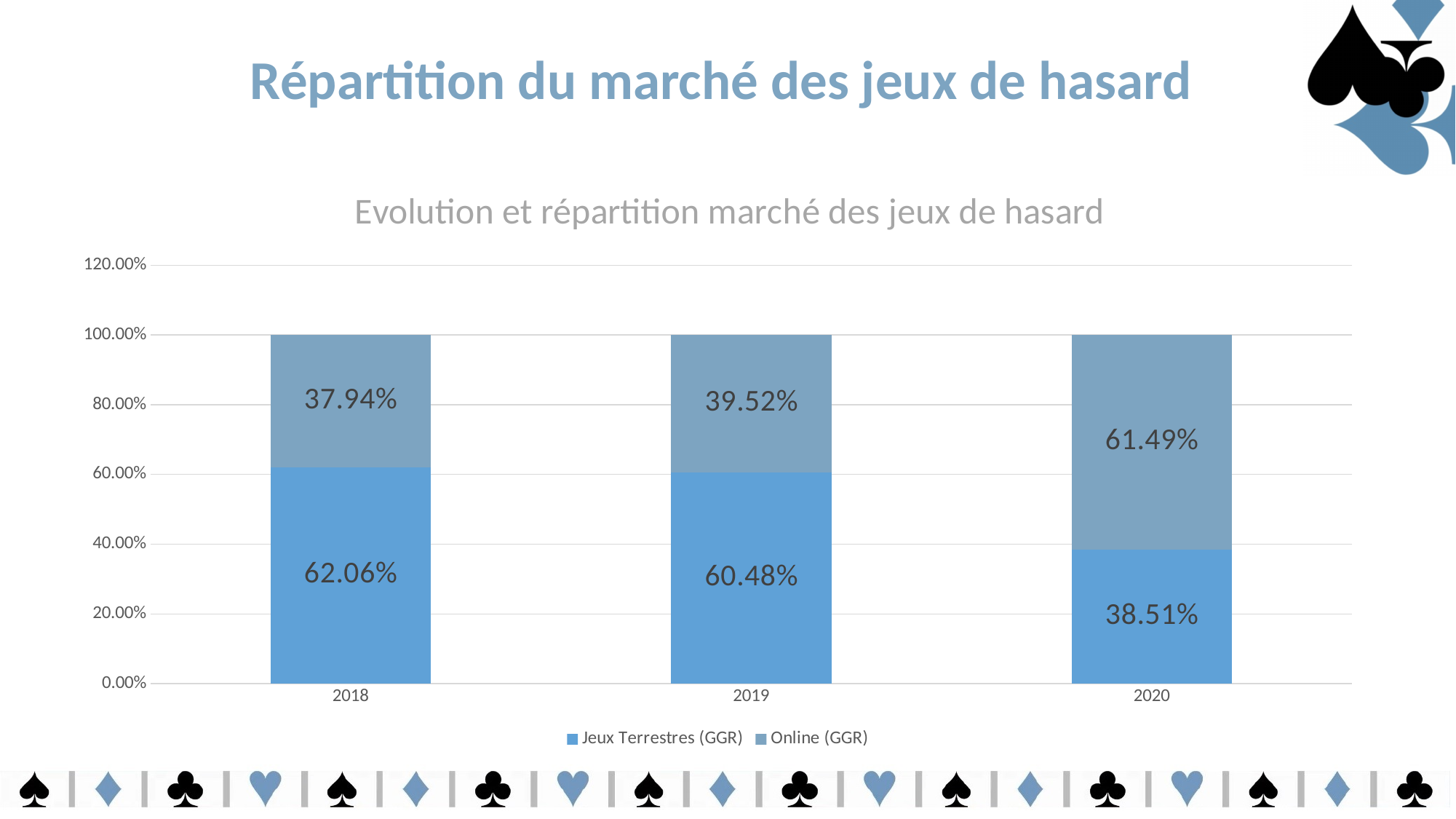
How many series does the legend list? 2 What is the value for Online (GGR) in 2019? 39.52% What is the value for Online (GGR) in 2020? 61.49% Which year has the lowest value for Online (GGR)? 2018 Which year has the highest value for Jeux Terrestres (GGR)? 2018 How many years are shown on the x axis? 3 Does the Jeux Terrestres (GGR) value rise or fall from 2018 to 2020? Fall In 2020, which is larger: Jeux Terrestres (GGR) or Online (GGR)? Online (GGR) What is the chart's title? Evolution et répartition marché des jeux de hasard What is the difference between the Online (GGR) value in 2020 and in 2019? 21.97% What is the value for Jeux Terrestres (GGR) in 2018? 62.06% What kind of chart is shown? Stacked bar chart